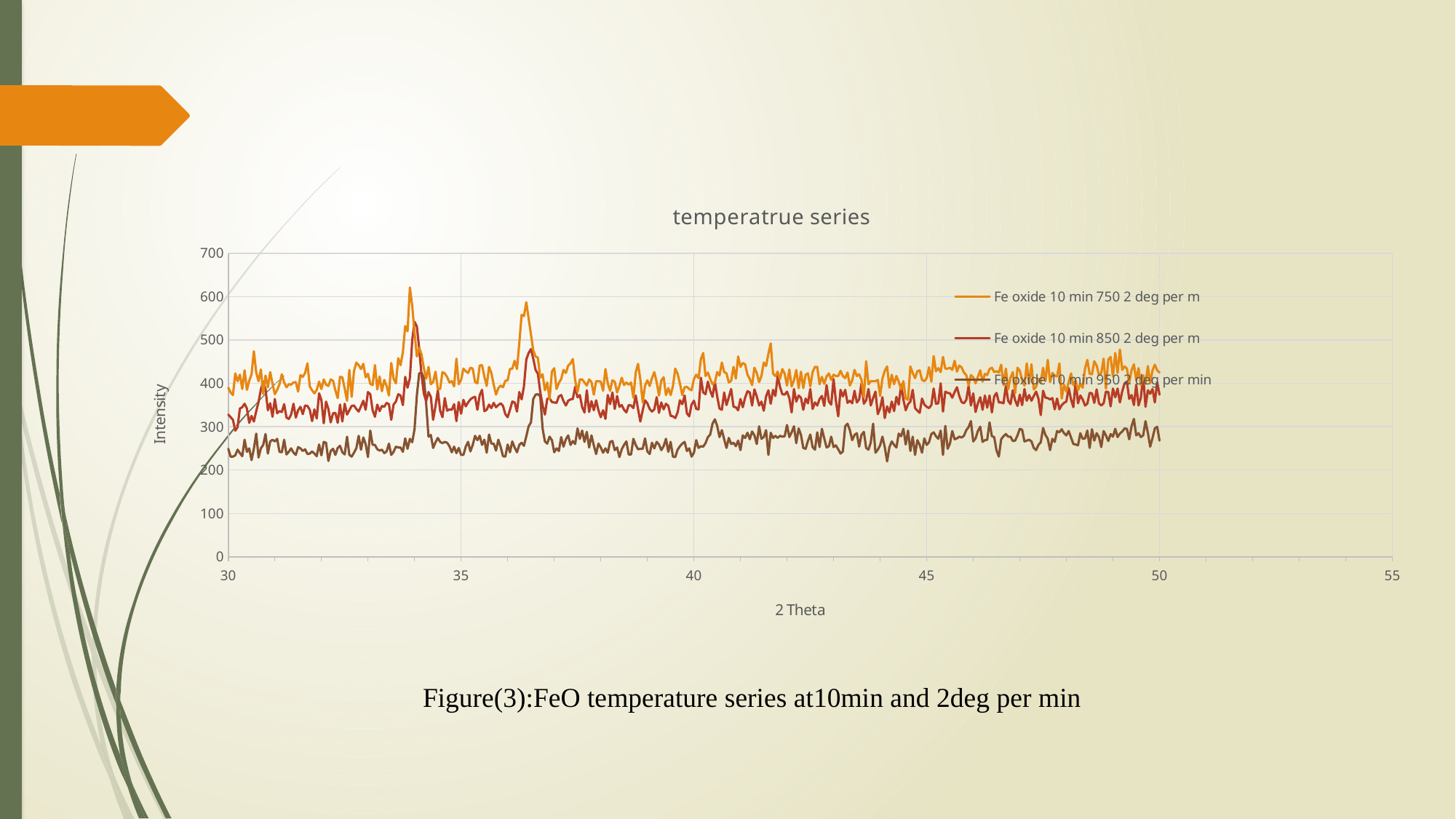
Is the intensity of the Fe oxide 10 min 850 2 deg per m series at 2 Theta 45 greater or less than 200? greater Which series has the lowest intensity across the 2 Theta range? Fe oxide 10 min 950 2 deg per min What kind of chart is shown on the slide? line chart At 2 Theta 45, which series has the larger intensity: Fe oxide 10 min 850 2 deg per m or Fe oxide 10 min 950 2 deg per min? Fe oxide 10 min 850 2 deg per m Is the intensity of the Fe oxide 10 min 950 2 deg per min series at 2 Theta 40 greater or less than 400? less What is the label of the x axis? 2 Theta How many series does the legend list? 3 Which series has the highest intensity across the 2 Theta range? Fe oxide 10 min 750 2 deg per m Is the peak intensity of the Fe oxide 10 min 950 2 deg per min series near 2 Theta 34 greater or less than 600? less What is the title of the chart? temperatrue series At 2 Theta 40, which series has the larger intensity: Fe oxide 10 min 750 2 deg per m or Fe oxide 10 min 950 2 deg per min? Fe oxide 10 min 750 2 deg per m